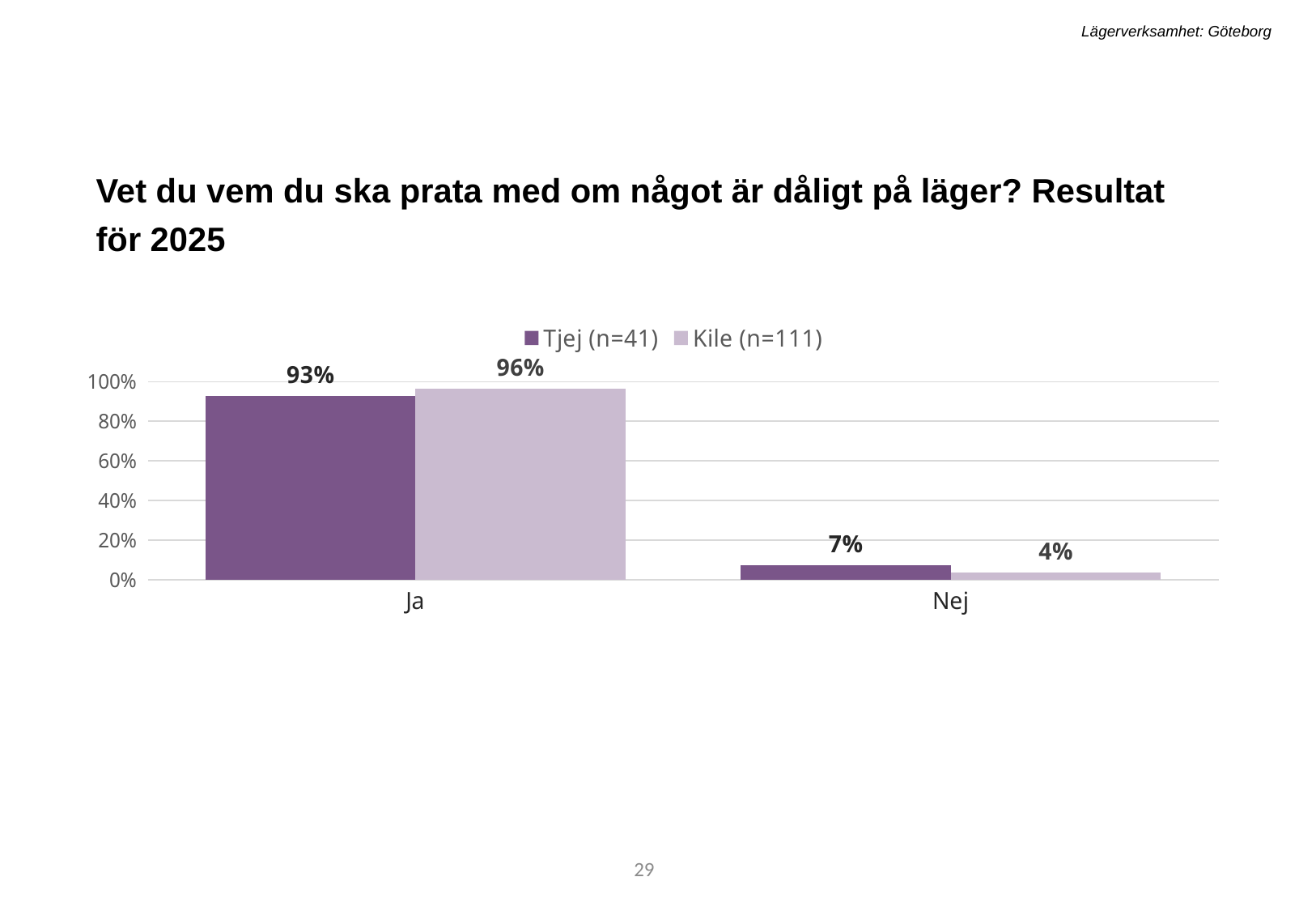
What is the value for Kile (n=111) in the Nej category? 4% How many series does the legend list? 2 What is the difference between the Kile (n=111) and Tjej (n=41) values in the Ja category? 3% How many categories are shown on the x axis? 2 Is the value for Tjej (n=41) in the Ja category greater or less than 80%? greater Which category has the highest value for the Kile (n=111) series? Ja Which category has the lowest value for the Tjej (n=41) series? Nej What is the value for Tjej (n=41) in the Ja category? 93% In the Nej category, which series has the larger value, Tjej (n=41) or Kile (n=111)? Tjej (n=41) What is the value for Tjej (n=41) in the Nej category? 7% What kind of chart is shown on the slide? bar chart What is the value for Kile (n=111) in the Ja category? 96%